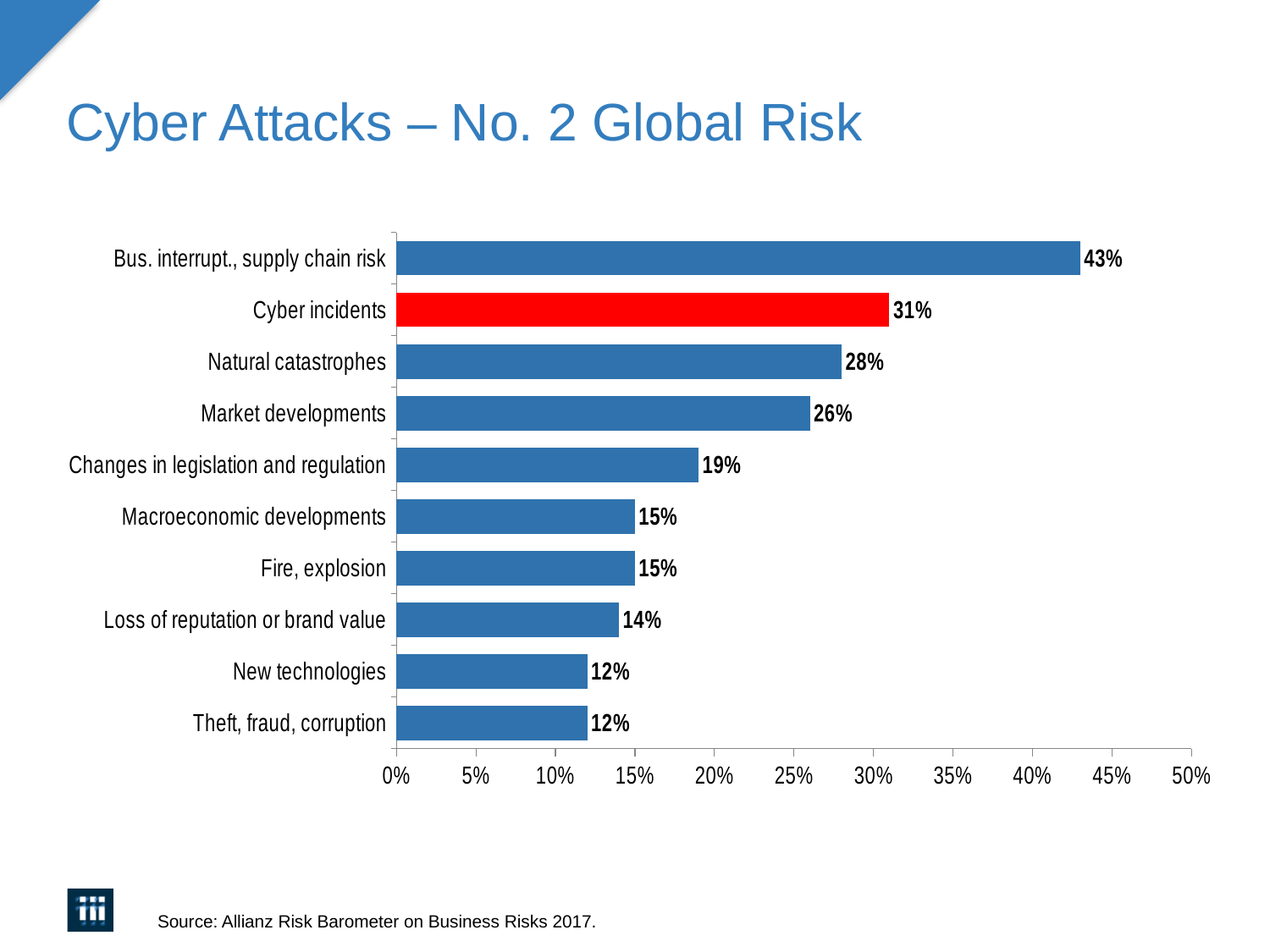
What is the difference between Bus. interrupt., supply chain risk and Cyber incidents? 12% Which bar is coloured red? Cyber incidents How many categories are shown in the chart? 10 Which category has the highest value? Bus. interrupt., supply chain risk Which is larger, Natural catastrophes or Market developments? Natural catastrophes What is the value for Loss of reputation or brand value? 14% What is the value for Changes in legislation and regulation? 19% Is the value for Cyber incidents greater or less than 30%? greater What is the value for Natural catastrophes? 28% What kind of chart is shown on the slide? Bar chart What is the difference between Market developments and Macroeconomic developments? 11% What is the value for Cyber incidents? 31%